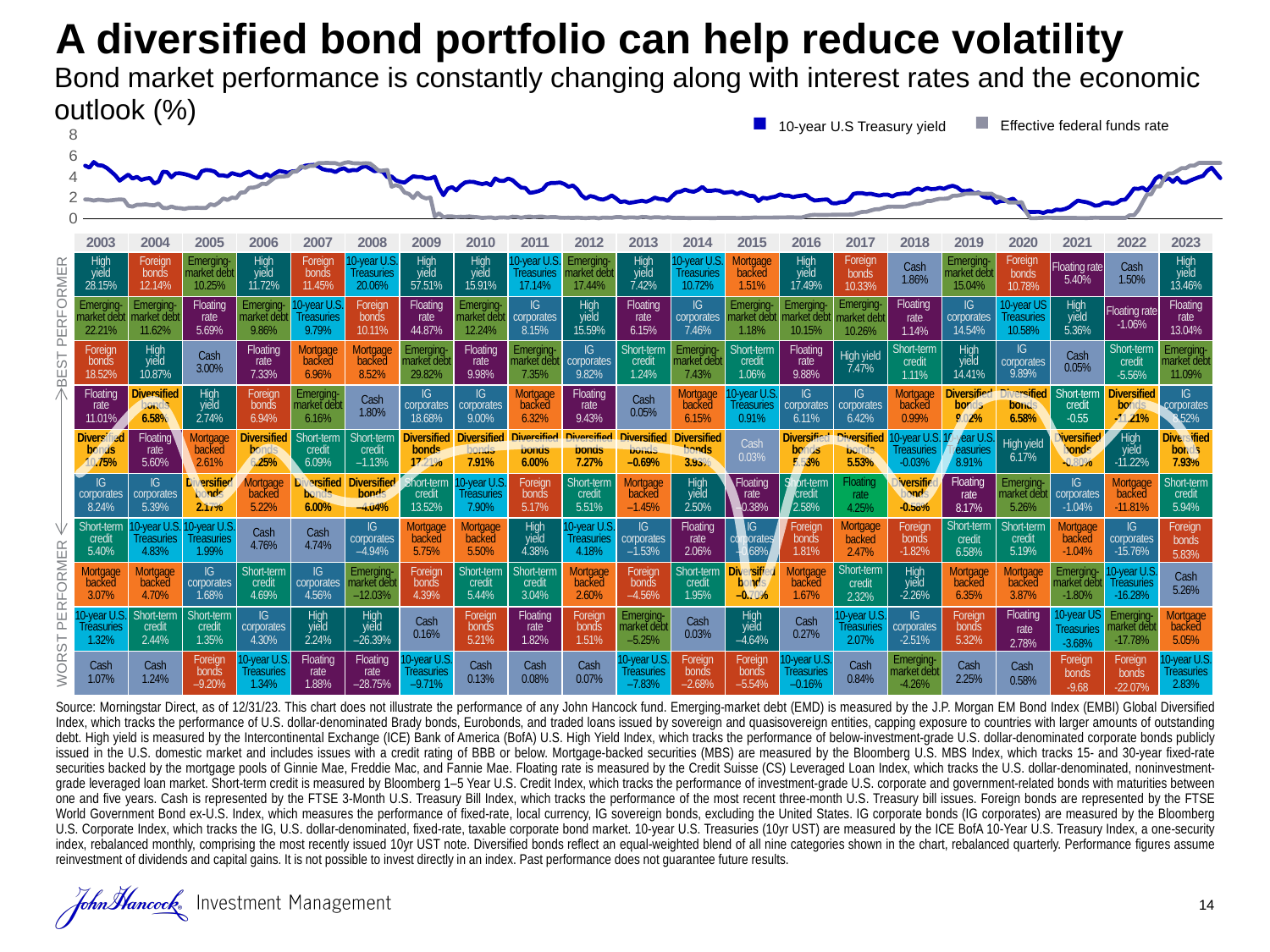
In the performance grid, what was the return for Diversified bonds in 2022? -11.21% What are the two series named in the legend of the top line chart? 10-year U.S. Treasury yield and Effective federal funds rate In the top line chart, is the Effective federal funds rate in 2007 greater or less than 4? greater In the top line chart, is the Effective federal funds rate in 2010 greater or less than 2? less In the performance grid, which category was the worst performer in 2008 and what was its return? Floating rate, -28.75% How many series does the legend of the top line chart list? 2 In the performance grid, which category was the best performer in 2009 and what was its return? High yield, 57.51% What kind of chart is shown at the top of the slide, above the year grid? Line chart In the performance grid, what is the difference between the 2023 returns of High yield (13.46%) and Floating rate (13.04%)? 0.42% How many years are shown as columns in the performance grid? 21 In the performance grid, what was the return for Cash in 2023? 5.26% In the performance grid, which had the higher return in 2013: High yield or Cash? High yield